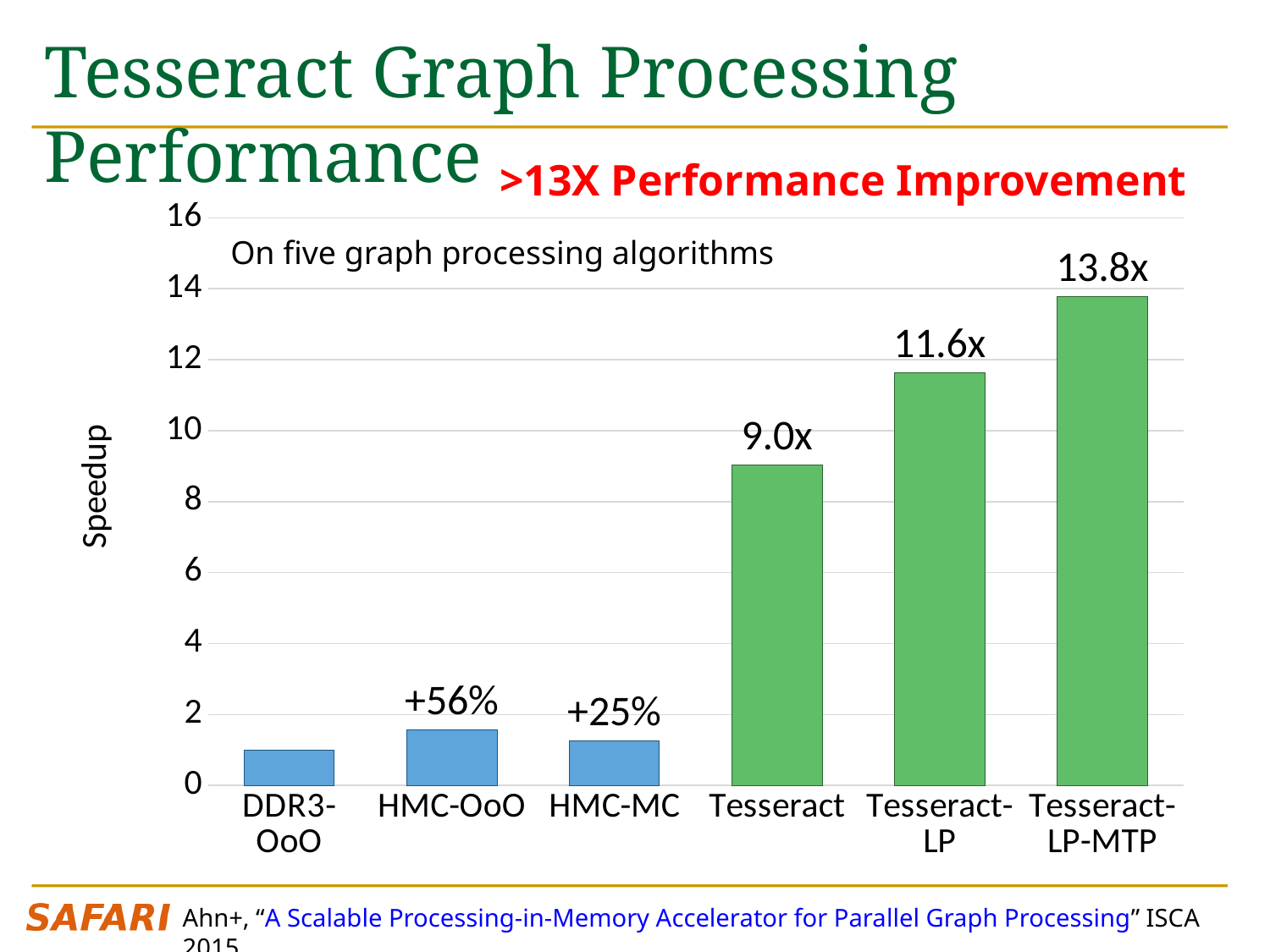
What label is printed above the HMC-MC bar? +25% Which category has the lowest speedup? DDR3-OoO How many categories are shown on the x axis? 6 What is the speedup value labeled for the Tesseract-LP bar? 11.6x What is the speedup value labeled for the Tesseract bar? 9.0x What is the difference between the Tesseract-LP-MTP and Tesseract speedup values? 4.8x What is the speedup value labeled for the Tesseract-LP-MTP bar? 13.8x Which category has the highest speedup? Tesseract-LP-MTP What label is printed above the HMC-OoO bar? +56% Is the value for DDR3-OoO greater or less than 2? less Which bar is taller, HMC-OoO or HMC-MC? HMC-OoO What is the label on the y axis? Speedup